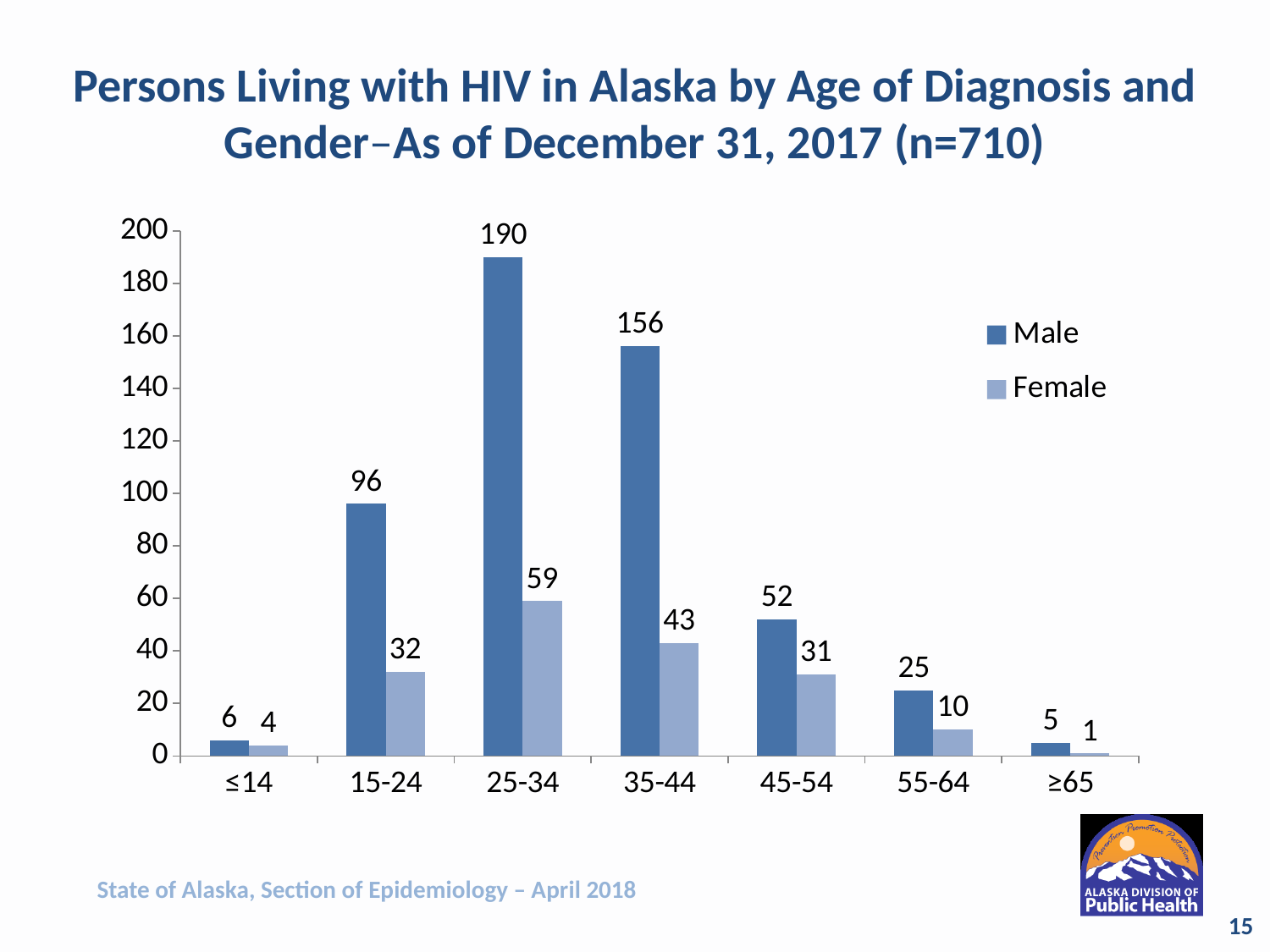
What is the Female value for the 35-44 age group? 43 Which age group has the lowest Female value? ≥65 Which series is shown in the darker blue colour? Male Which age group has the highest Male value? 25-34 Which is larger, the Male value for 45-54 or the Female value for 25-34? Female value for 25-34 How many age groups are shown on the x axis? 7 How many series does the legend list? 2 What kind of chart is shown on the slide? Bar chart What is the Female value for the 55-64 age group? 10 What is the difference between the Male and Female values for the 15-24 age group? 64 Is the Male value for 35-44 greater or less than 140? greater What is the Male value for the 25-34 age group? 190